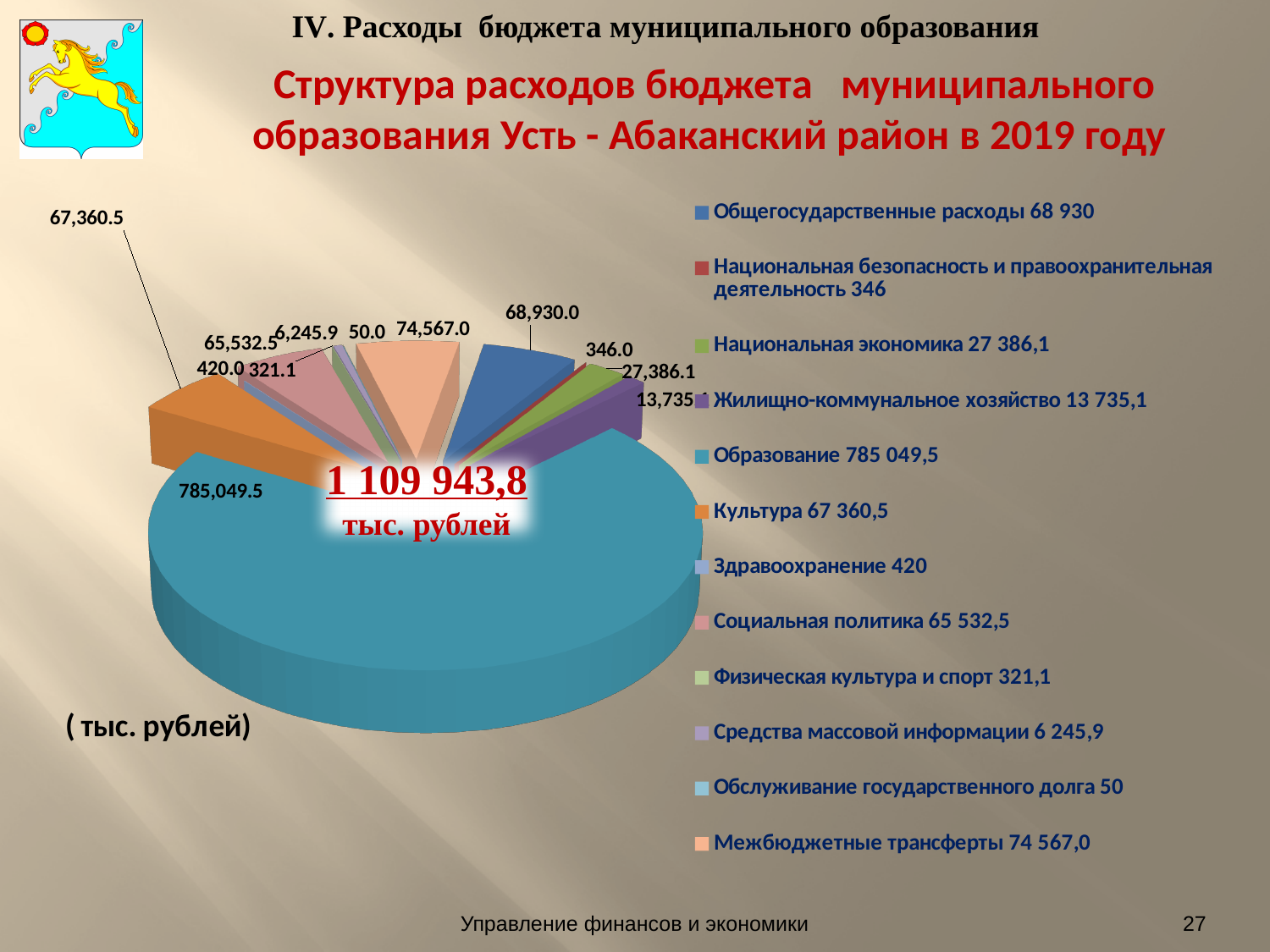
Which category has the largest share of the pie? Образование What type of chart is shown on the slide? Pie chart Which is larger, Культура or Социальная политика? Культура Which category has the smallest value in the pie chart? Обслуживание государственного долга What is the value for Общегосударственные расходы? 68,930.0 What is the difference between Общегосударственные расходы (68,930.0) and Культура (67,360.5)? 1,569.5 How many categories does the legend of the pie chart list? 12 What total amount is printed in the centre of the pie chart? 1 109 943,8 тыс. рублей What is the value for Образование in the pie chart? 785,049.5 What is the value for Межбюджетные трансферты? 74,567.0 What is the value for Жилищно-коммунальное хозяйство? 13,735.1 What is the difference between Национальная экономика (27,386.1) and Жилищно-коммунальное хозяйство (13,735.1)? 13,651.0